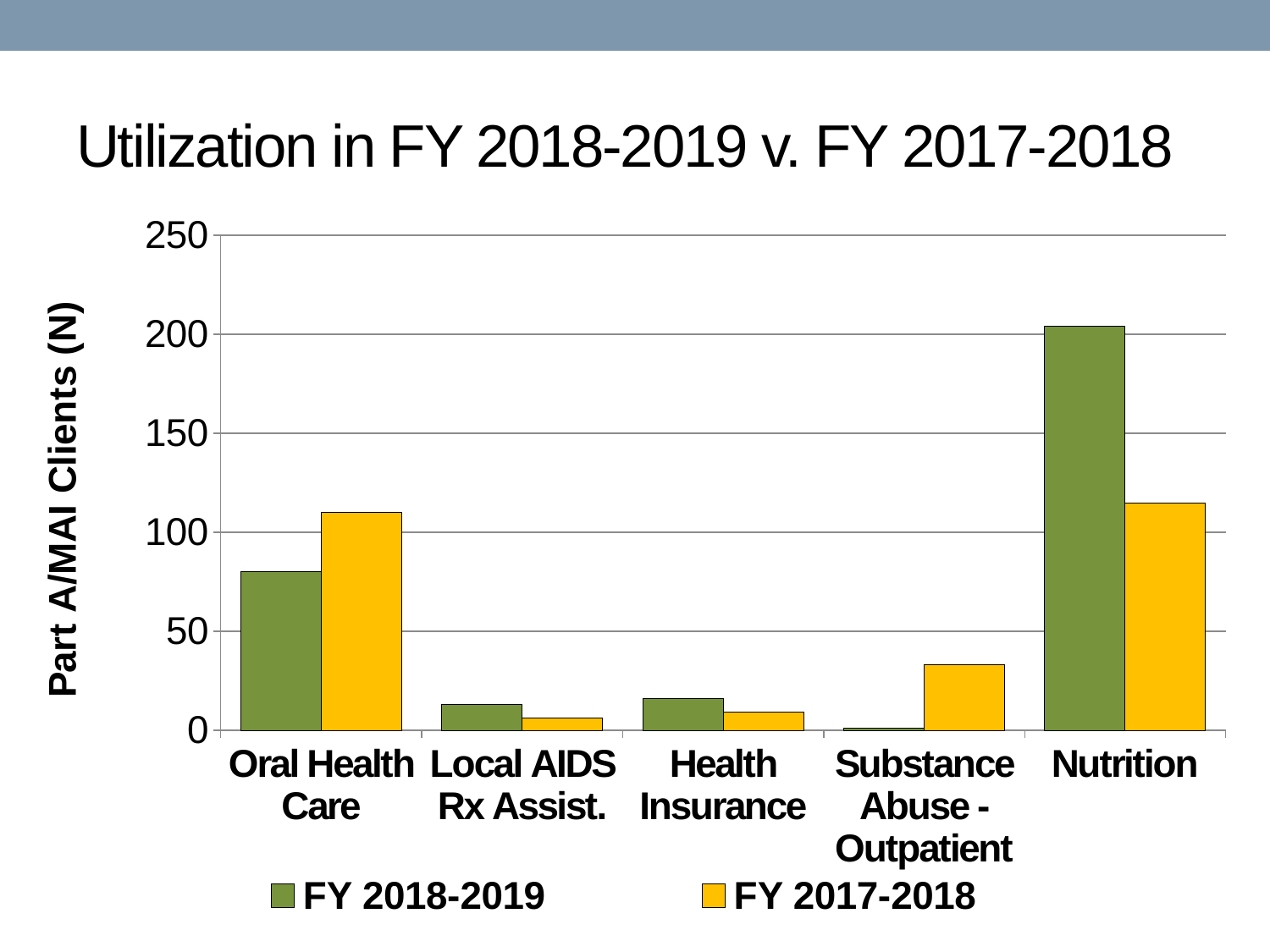
How many service categories are shown on the x axis? 5 Which category has the highest value for FY 2018-2019? Nutrition How many series does the legend list? 2 Which category has the lowest value for FY 2018-2019? Substance Abuse - Outpatient Is the FY 2017-2018 value for Substance Abuse - Outpatient greater or less than 50? less Is the FY 2018-2019 value for Oral Health Care greater or less than 100? less For Nutrition, which is larger: FY 2018-2019 or FY 2017-2018? FY 2018-2019 What is the label of the y axis? Part A/MAI Clients (N) What kind of chart is shown on the slide? bar chart For Substance Abuse - Outpatient, which is larger: FY 2018-2019 or FY 2017-2018? FY 2017-2018 For Oral Health Care, which is larger: FY 2018-2019 or FY 2017-2018? FY 2017-2018